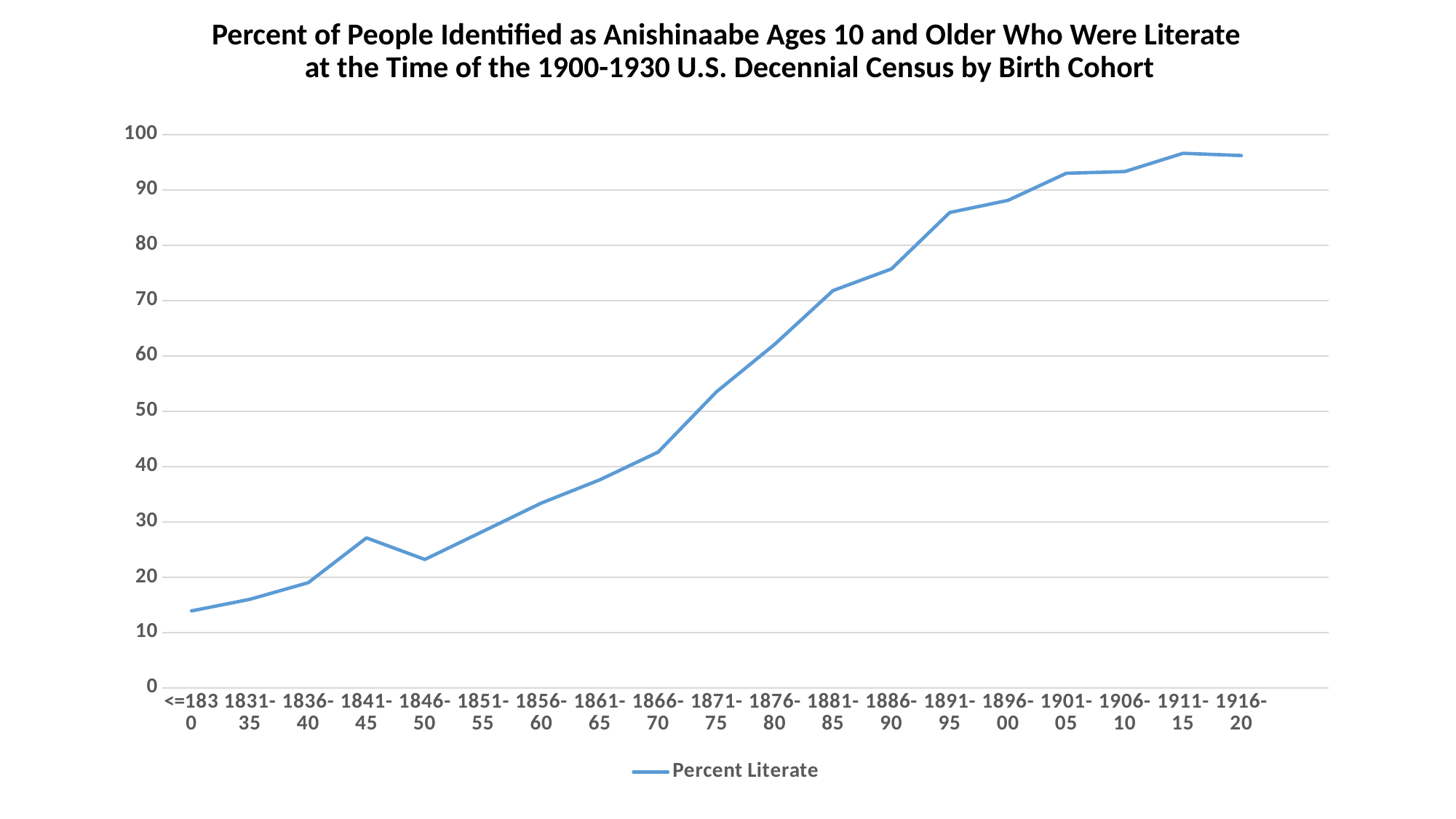
Is the value for the 1846-50 birth cohort greater or less than 30? less Is the value for the 1841-45 birth cohort greater or less than 20? greater How many birth cohorts are plotted along the x axis? 19 Is the value for the 1881-85 birth cohort greater or less than 70? greater Which has the larger value, the 1866-70 cohort or the 1876-80 cohort? 1876-80 What kind of chart is shown on the slide? line chart Which has the larger value, the 1841-45 cohort or the 1846-50 cohort? 1841-45 What is the name of the series shown in the legend? Percent Literate Overall, do the values rise or fall from the earliest birth cohort to the latest? rise How many series does the legend list? 1